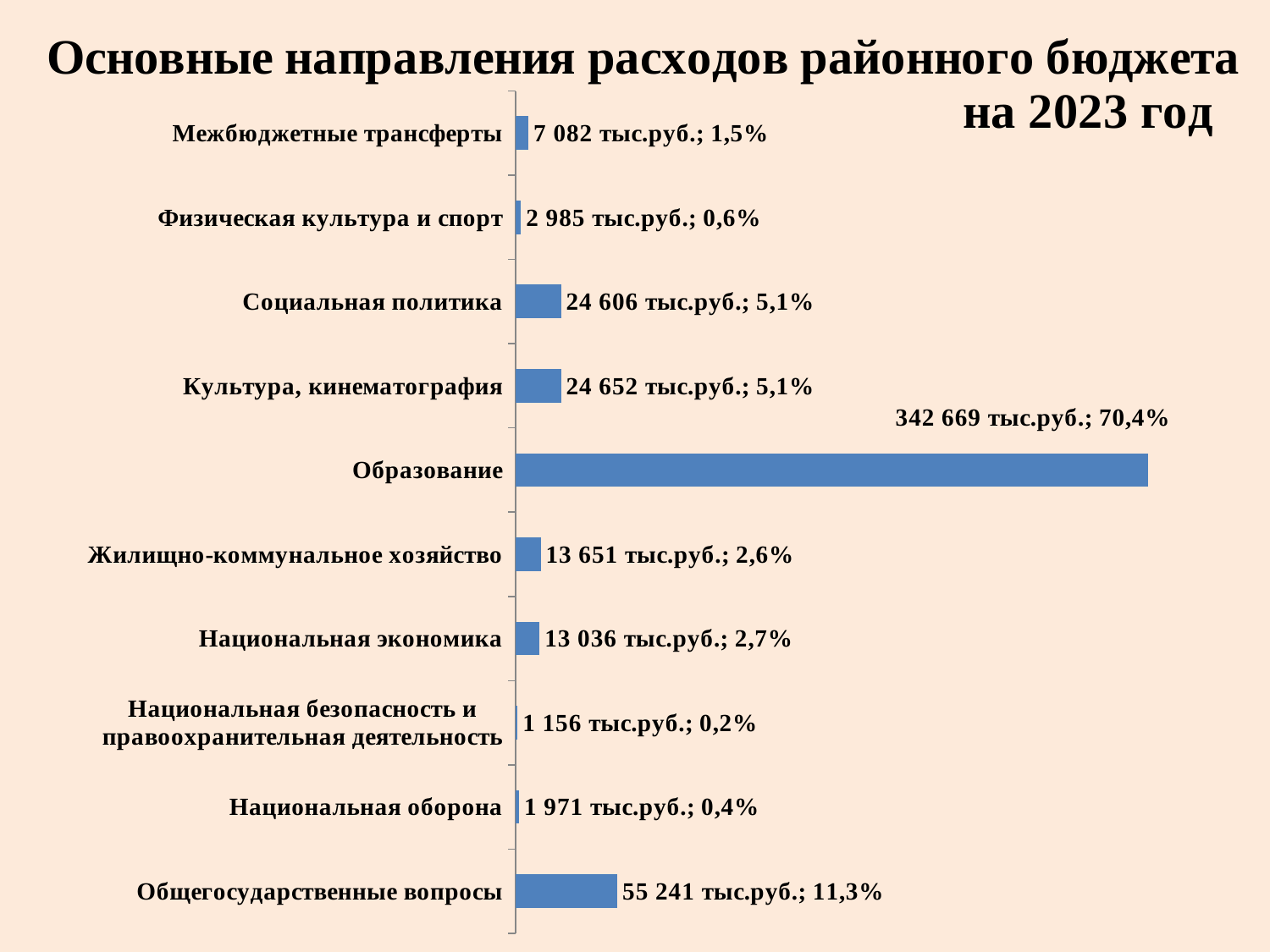
What value in тыс.руб. is shown for Жилищно-коммунальное хозяйство? 13 651 тыс.руб. Which is larger, the value for Общегосударственные вопросы or the value for Межбюджетные трансферты? Общегосударственные вопросы What percentage share is shown for Общегосударственные вопросы? 11,3% What percentage is shown for Национальная оборона? 0,4% Which category has the lowest value? Национальная безопасность и правоохранительная деятельность Which category has the highest value? Образование What is the title of the chart? Основные направления расходов районного бюджета на 2023 год What is the difference in тыс.руб. between Жилищно-коммунальное хозяйство and Национальная экономика? 615 тыс.руб. What value is shown for Образование? 342 669 тыс.руб.; 70,4% What kind of chart is shown on the slide? Bar chart What is the difference in тыс.руб. between Общегосударственные вопросы and Социальная политика? 30 635 тыс.руб. How many categories are shown in the chart? 10